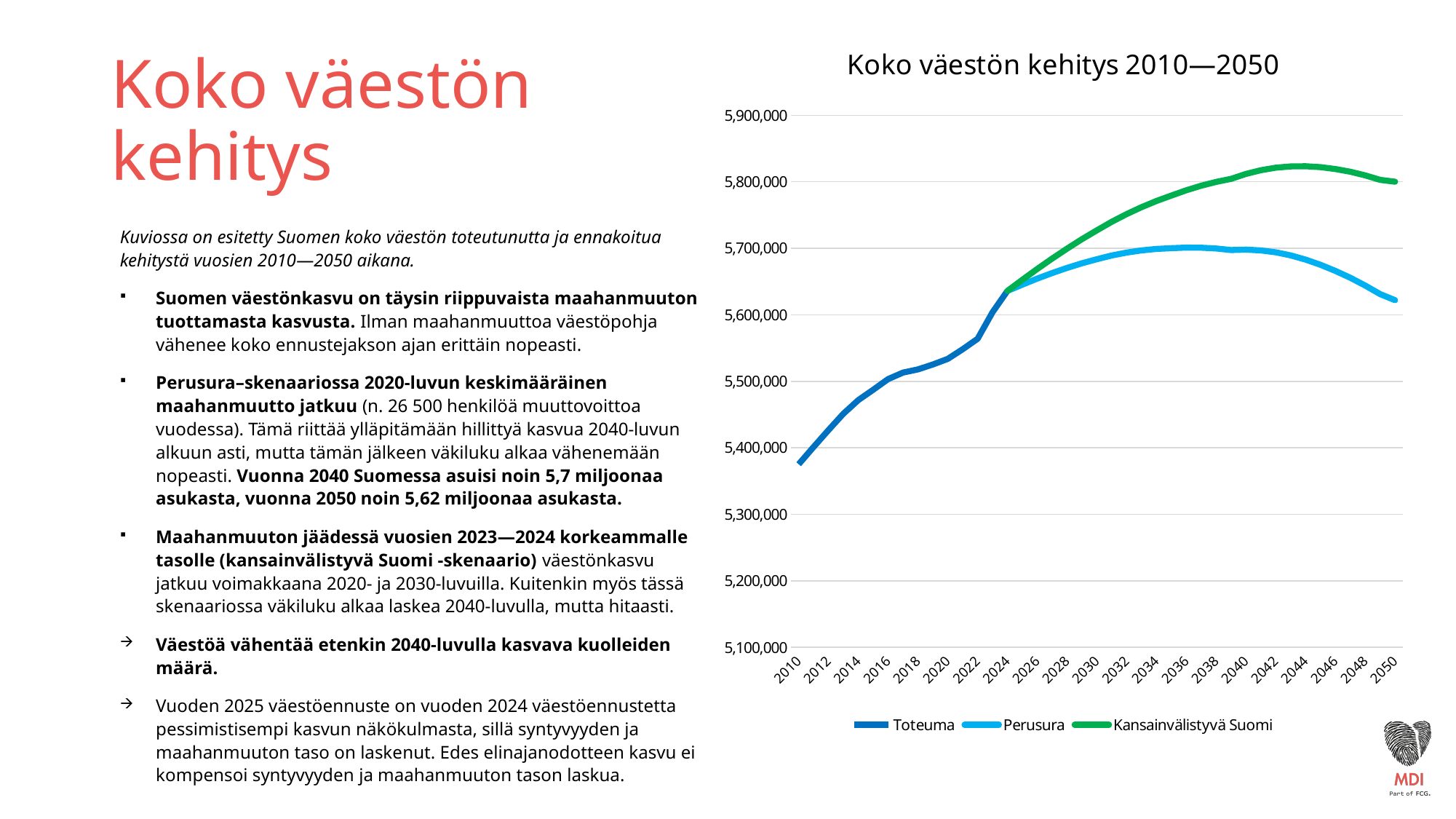
Is the Toteuma value for 2020 greater or less than 5,500,000? greater How many year labels are shown on the x axis? 21 Does the Perusura series rise or fall from 2040 to 2050? fall Which series is drawn in green? Kansainvälistyvä Suomi Is the Kansainvälistyvä Suomi value for 2044 greater or less than 5,800,000? greater In 2050, which series has the higher value, Perusura or Kansainvälistyvä Suomi? Kansainvälistyvä Suomi Does the Toteuma series rise or fall from 2010 to 2024? rise Is the Perusura value for 2050 greater or less than 5,600,000? greater How many series does the legend list? 3 What kind of chart is shown on the slide? line chart What is the title of the chart? Koko väestön kehitys 2010—2050